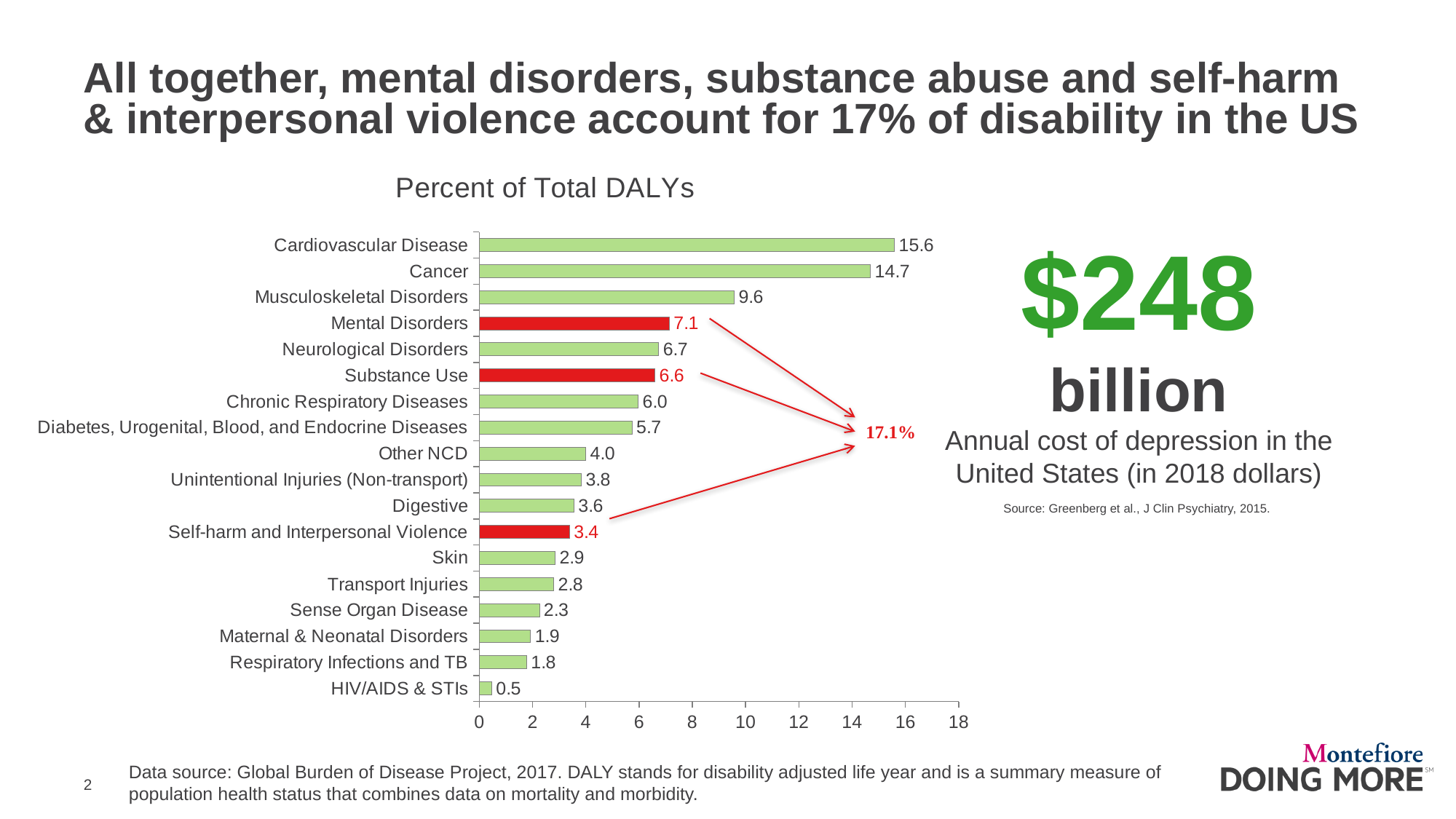
Which is larger, the value for Mental Disorders or the value for Neurological Disorders? Mental Disorders What is the value for Cardiovascular Disease? 15.6 Which category has the lowest value? HIV/AIDS & STIs What is the value for Substance Use? 6.6 How many categories are shown in the chart? 18 Is the value for Musculoskeletal Disorders greater or less than 8? greater What kind of chart is shown on the slide? bar chart What is the title of the chart? Percent of Total DALYs Which category has the highest value? Cardiovascular Disease What is the difference between the values for Cardiovascular Disease and Cancer? 0.9 What is the value for Self-harm and Interpersonal Violence? 3.4 What is the total of the values for Mental Disorders, Substance Use, and Self-harm and Interpersonal Violence? 17.1